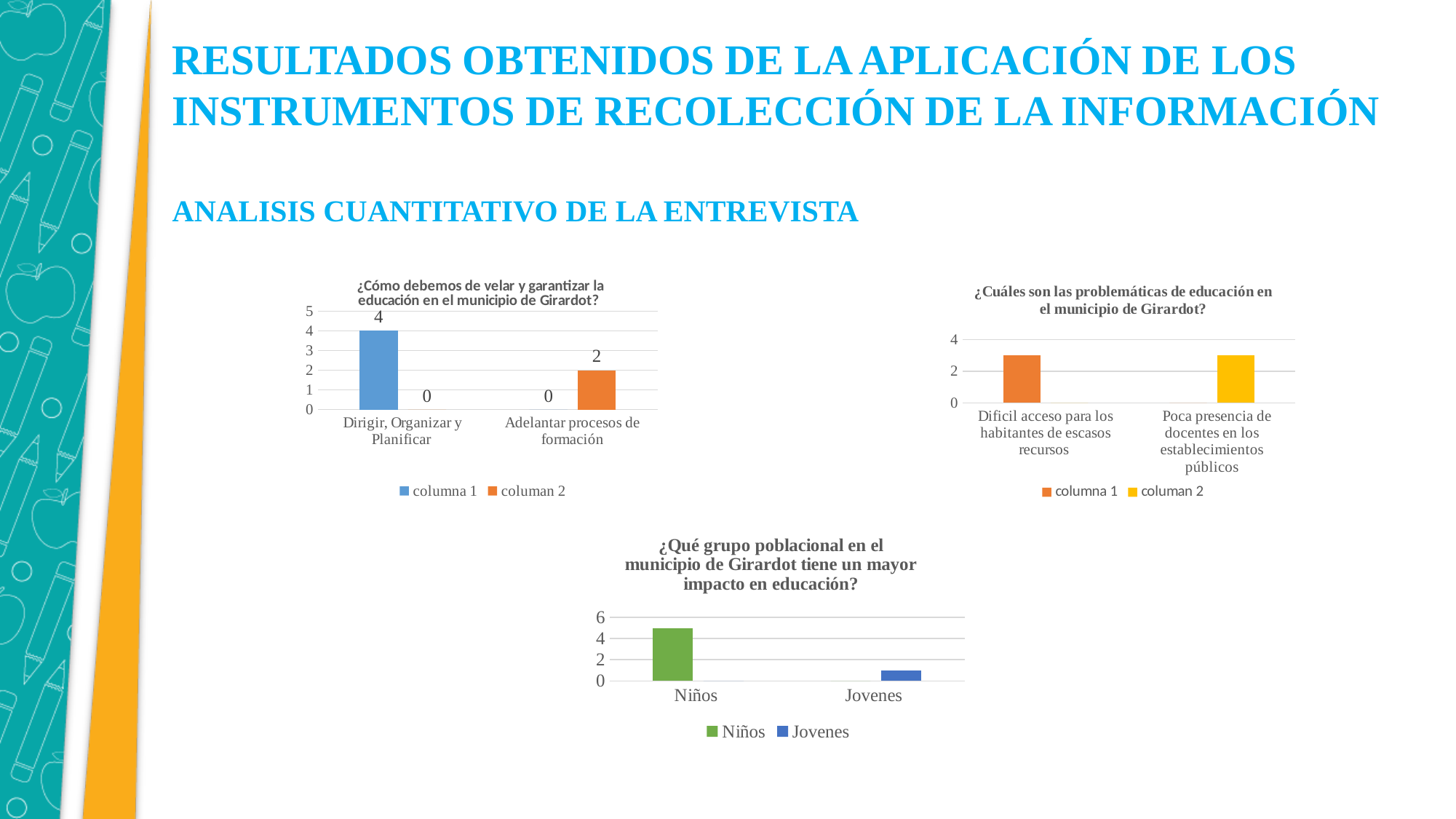
In the chart titled '¿Qué grupo poblacional en el municipio de Girardot tiene un mayor impacto en educación?', what colour is the bar for Niños? green In the chart titled '¿Cuáles son las problemáticas de educación en el municipio de Girardot?', is the value for 'Dificil acceso para los habitantes de escasos recursos' greater or less than 2? greater In the chart titled '¿Qué grupo poblacional en el municipio de Girardot tiene un mayor impacto en educación?', is the value for Niños greater or less than 4? greater In the chart titled '¿Cómo debemos de velar y garantizar la educación en el municipio de Girardot?', what is the value of columan 2 for 'Adelantar procesos de formación'? 2 In the chart titled '¿Cómo debemos de velar y garantizar la educación en el municipio de Girardot?', what is the value of columna 1 for 'Dirigir, Organizar y Planificar'? 4 In the chart titled '¿Qué grupo poblacional en el municipio de Girardot tiene un mayor impacto en educación?', which category has the highest value? Niños In the chart titled '¿Cómo debemos de velar y garantizar la educación en el municipio de Girardot?', which category has the highest value? Dirigir, Organizar y Planificar In the chart titled '¿Cómo debemos de velar y garantizar la educación en el municipio de Girardot?', how many series does the legend list? 2 In the chart titled '¿Cómo debemos de velar y garantizar la educación en el municipio de Girardot?', what is the difference between the columna 1 value for 'Dirigir, Organizar y Planificar' and the columan 2 value for 'Adelantar procesos de formación'? 2 In the chart titled '¿Qué grupo poblacional en el municipio de Girardot tiene un mayor impacto en educación?', is the value for Jovenes greater or less than 2? less In the chart titled '¿Cuáles son las problemáticas de educación en el municipio de Girardot?', what kind of chart is it? bar chart In the chart titled '¿Cuáles son las problemáticas de educación en el municipio de Girardot?', how many categories are shown on the x axis? 2